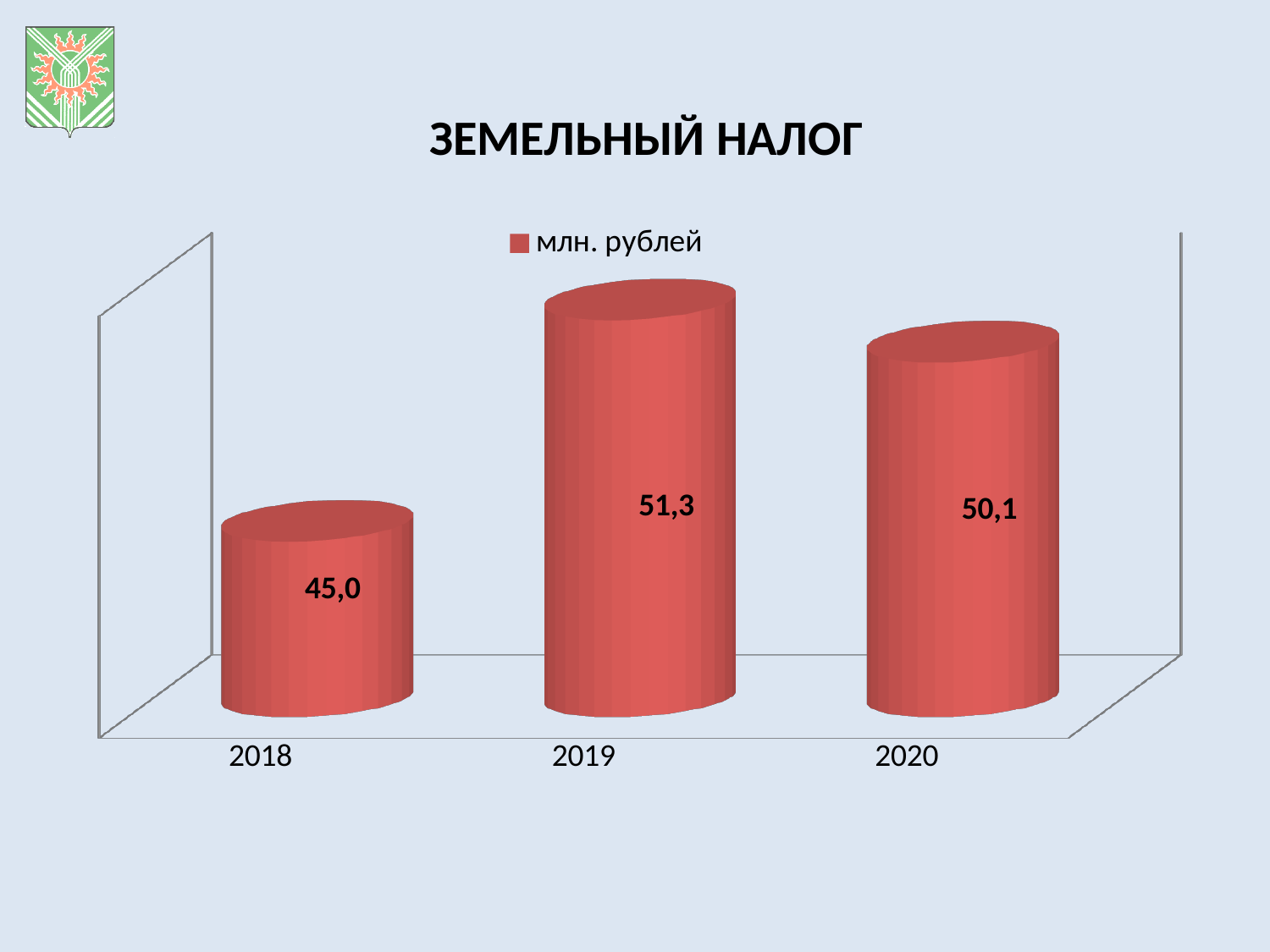
Which is larger, the value for 2018 or the value for 2020? 2020 How many years are shown on the chart? 3 What is the value for 2018? 45,0 What is the difference between the values for 2019 and 2020? 1,2 Which year has the lowest value? 2018 What is the title of the chart? ЗЕМЕЛЬНЫЙ НАЛОГ How many series does the legend list? 1 What is the value for 2020? 50,1 What is the value for 2019? 51,3 What is the difference between the values for 2019 and 2018? 6,3 What kind of chart is shown on the slide? bar chart Which year has the highest value? 2019